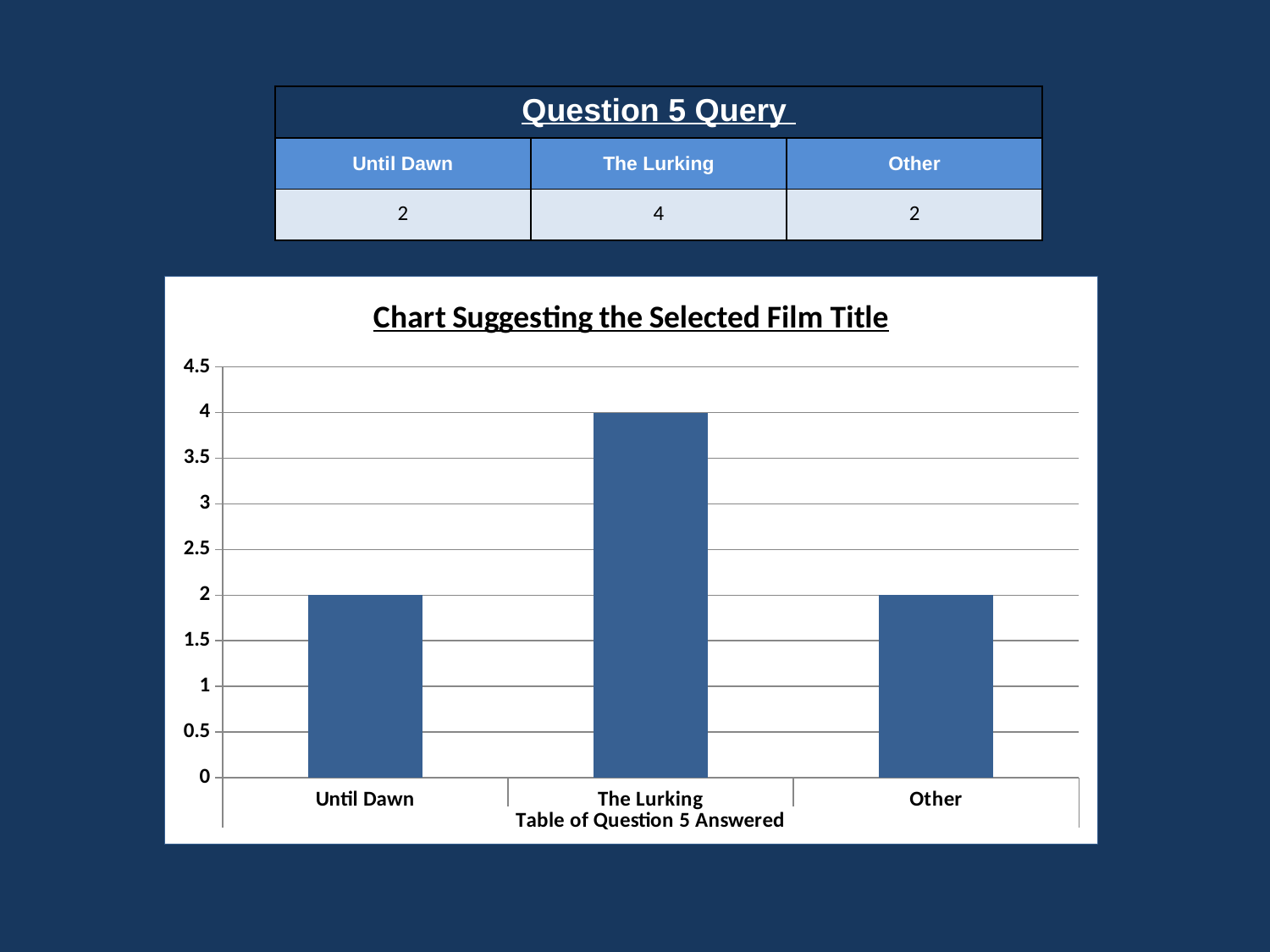
What is the title of the chart? Chart Suggesting the Selected Film Title Which category has the highest bar in the chart? The Lurking What kind of chart is shown on the slide? bar chart Is the value for Until Dawn greater or less than 3? less What is the difference between the values for The Lurking and Until Dawn? 2 What is the value for Until Dawn in the chart? 2 How many categories are shown on the x axis of the chart? 3 What is the value for The Lurking in the chart? 4 Is the value for The Lurking greater or less than 3? greater Which is larger, the value for The Lurking or the value for Other? The Lurking What is the x-axis title of the chart? Table of Question 5 Answered What is the value for Other in the chart? 2